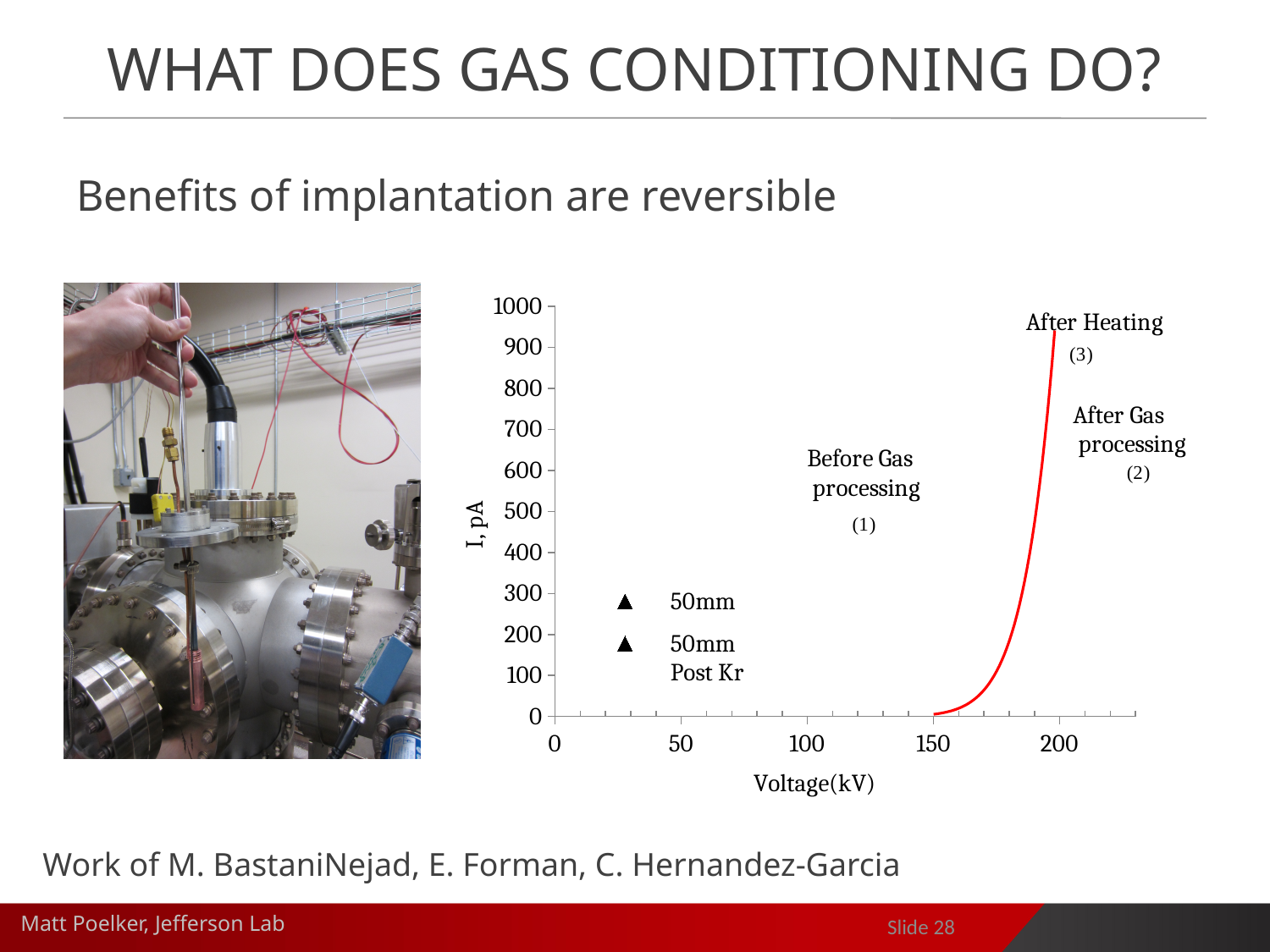
Is the current at 190 kV greater or less than 200 pA? greater Is the current at 175 kV greater or less than 500 pA? less What is the label of the x axis of the chart? Voltage(kV) Is the current at 150 kV greater or less than 100 pA? less What kind of chart is shown on the slide? line chart Does the current rise or fall as the voltage increases along the x axis? rises What is the label of the y axis of the chart? I, pA How many series does the chart's legend list? 2